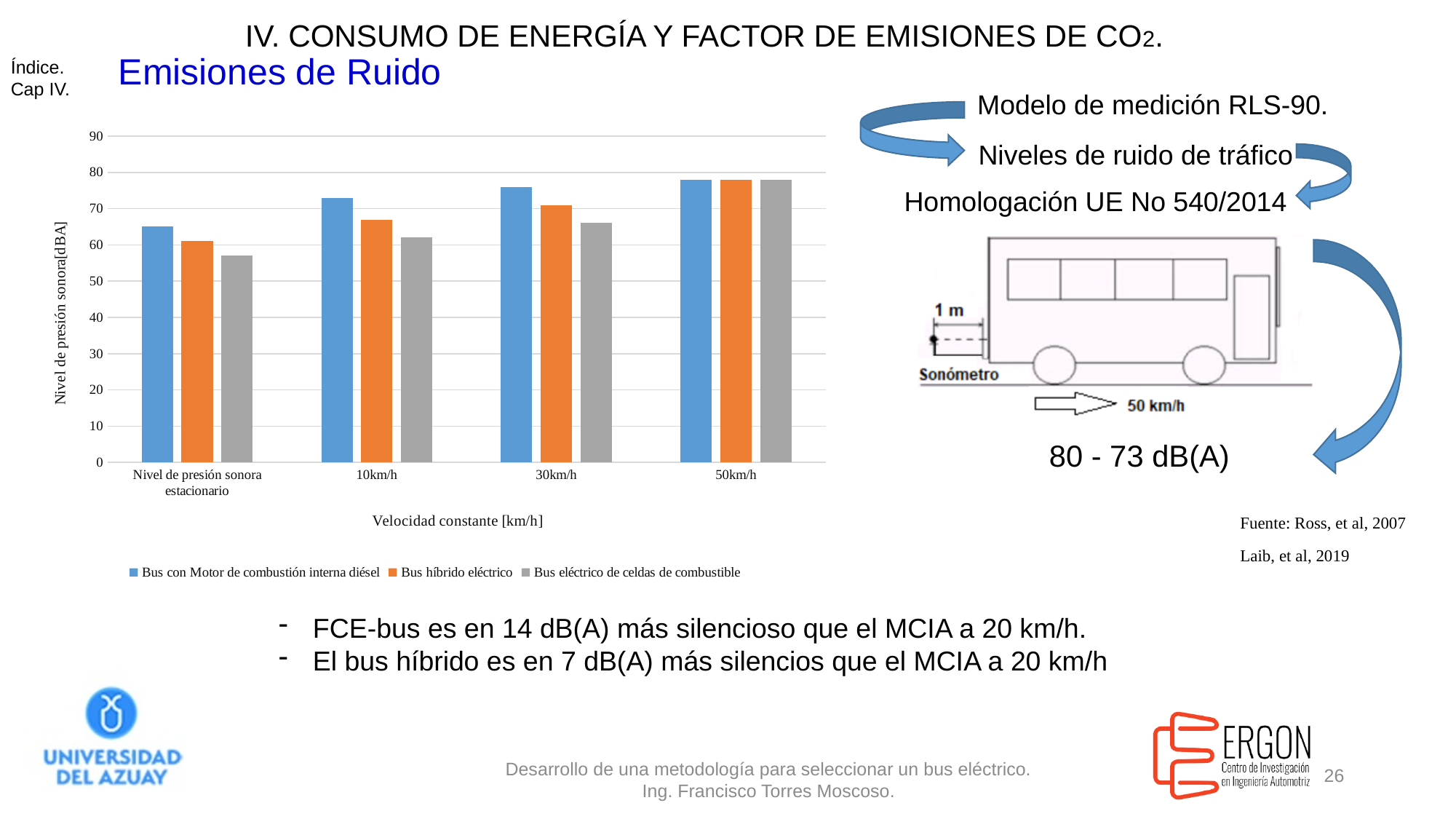
At 10km/h, which is larger: the value for Bus con Motor de combustión interna diésel or the value for Bus eléctrico de celdas de combustible? Bus con Motor de combustión interna diésel How many series does the chart legend list? 3 Is the value for Bus eléctrico de celdas de combustible at Nivel de presión sonora estacionario greater or less than 60? less Which category has the lowest value for Bus híbrido eléctrico? Nivel de presión sonora estacionario What is the label of the chart's y axis? Nivel de presión sonora[dBA] Is the value for Bus con Motor de combustión interna diésel at 10km/h greater or less than 70? greater What kind of chart is shown on the slide? bar chart Do the values for Bus eléctrico de celdas de combustible rise or fall from Nivel de presión sonora estacionario to 50km/h? rise How many categories are shown along the x axis of the chart? 4 Is the value for Bus híbrido eléctrico at 30km/h greater or less than 80? less Which colour represents Bus híbrido eléctrico in the chart? orange